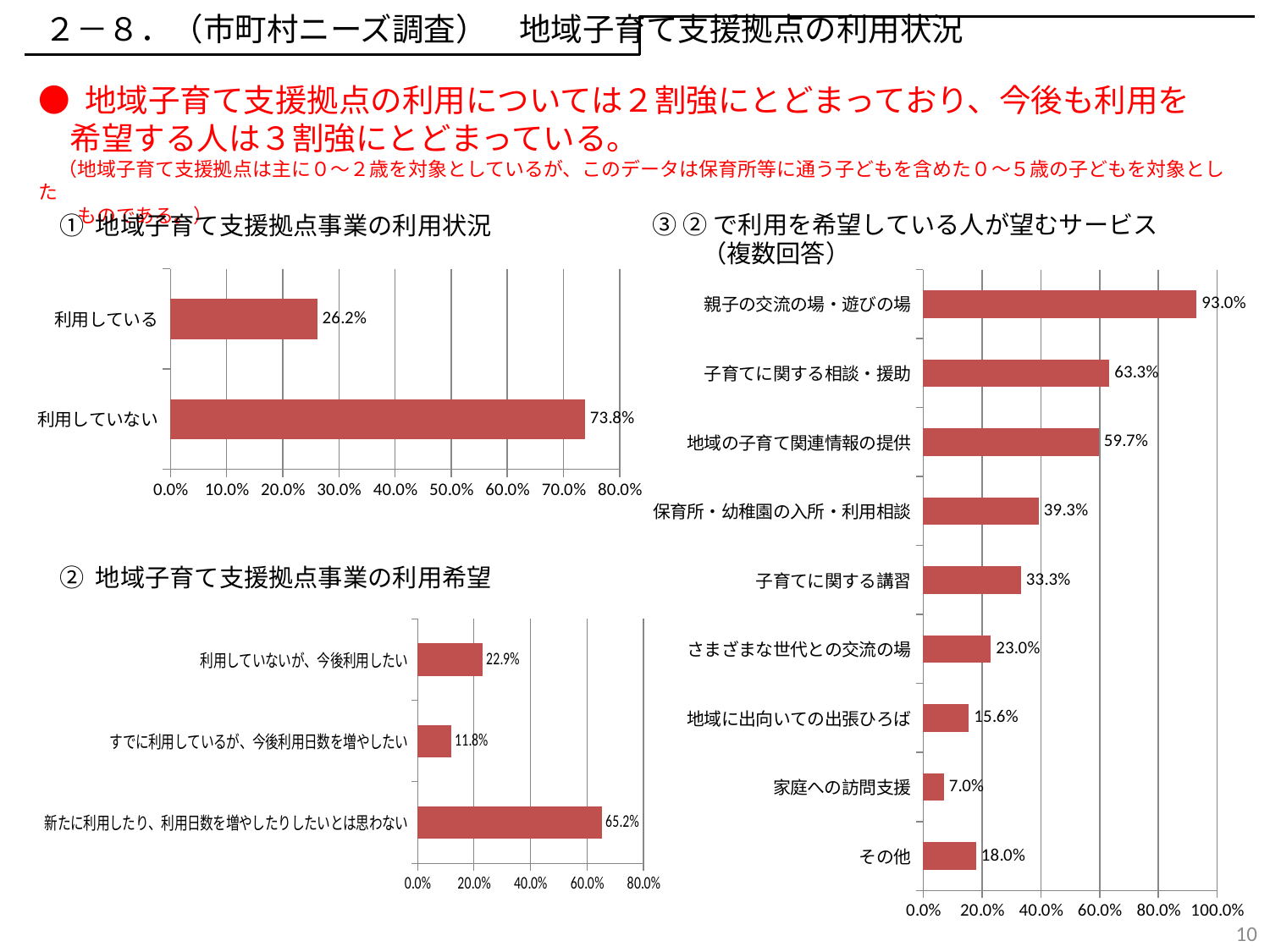
In the chart ②地域子育て支援拠点事業の利用希望, how many categories are shown? 3 In the chart ②地域子育て支援拠点事業の利用希望, which category has the highest value? 新たに利用したり、利用日数を増やしたりしたいとは思わない In the chart ③②で利用を希望している人が望むサービス, how many categories are shown? 9 In the chart ③②で利用を希望している人が望むサービス, what is the difference between 保育所・幼稚園の入所・利用相談 and 子育てに関する講習? 6.0% In the chart ①地域子育て支援拠点事業の利用状況, what is the difference between 利用していない and 利用している? 47.6% In the chart ②地域子育て支援拠点事業の利用希望, what is the value for すでに利用しているが、今後利用日数を増やしたい? 11.8% In the chart ③②で利用を希望している人が望むサービス, what is the value for 親子の交流の場・遊びの場? 93.0% In the chart ③②で利用を希望している人が望むサービス, which is larger: 子育てに関する相談・援助 or 地域の子育て関連情報の提供? 子育てに関する相談・援助 In the chart ①地域子育て支援拠点事業の利用状況, what is the value for 利用していない? 73.8% What type of chart is ①地域子育て支援拠点事業の利用状況? Bar chart In the chart ①地域子育て支援拠点事業の利用状況, what is the value for 利用している? 26.2% In the chart ③②で利用を希望している人が望むサービス, which category has the lowest value? 家庭への訪問支援